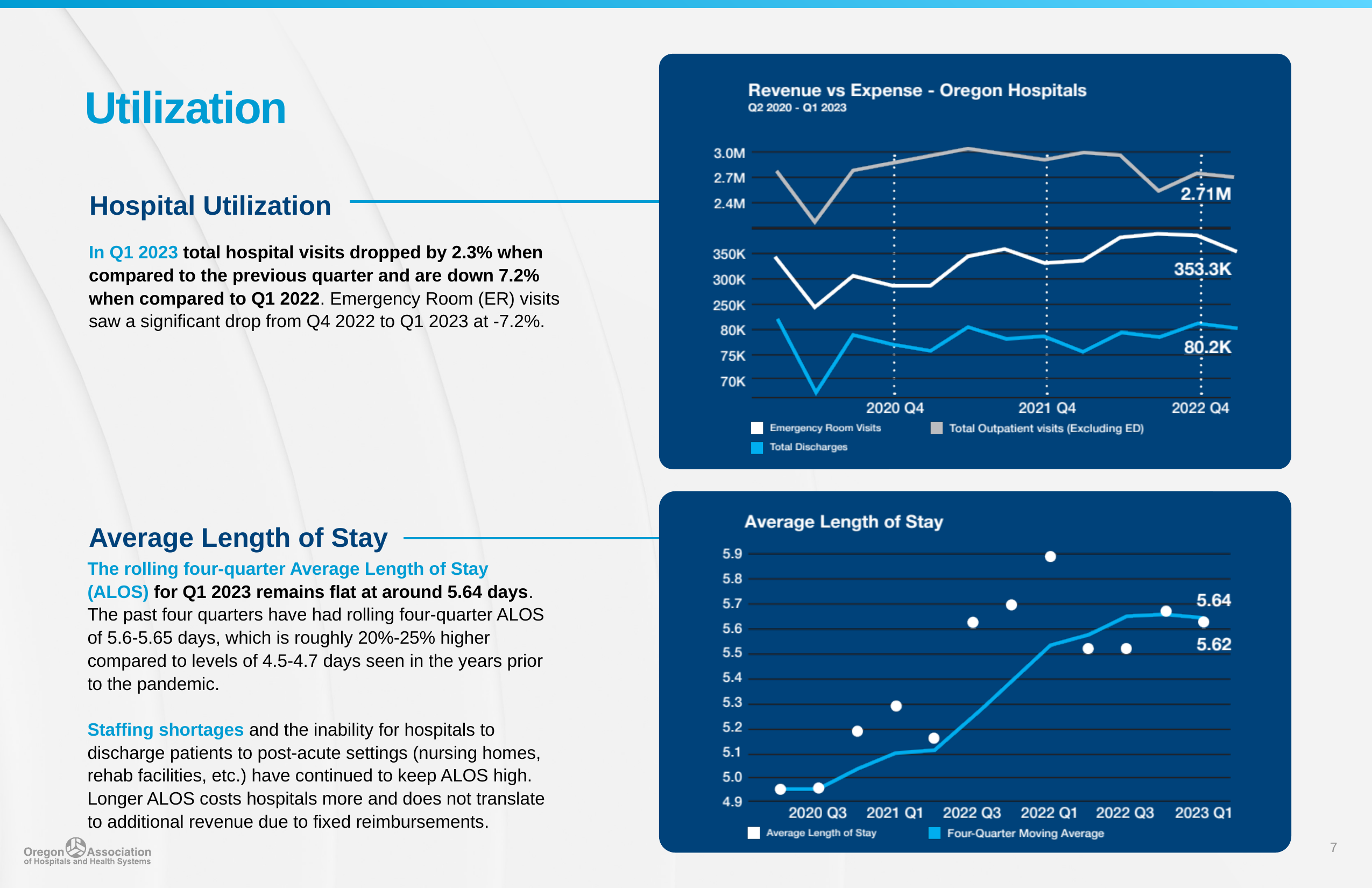
What time period is shown in the subtitle of the 'Revenue vs Expense - Oregon Hospitals' chart? Q2 2020 - Q1 2023 In the 'Average Length of Stay' chart, is the highest Average Length of Stay point greater or less than 5.8? greater How many series does the legend of the 'Revenue vs Expense - Oregon Hospitals' chart list? 3 In the 'Revenue vs Expense - Oregon Hospitals' chart, is the lowest point of the Total Discharges line greater or less than 70K? less In the 'Revenue vs Expense - Oregon Hospitals' chart, what value is labeled at the end of the Total Discharges line? 80.2K In the 'Average Length of Stay' chart, does the Four-Quarter Moving Average line generally rise or fall from left to right? Rise What type of chart is the 'Revenue vs Expense - Oregon Hospitals' chart? Line chart In the 'Revenue vs Expense - Oregon Hospitals' chart, what value is labeled at the end of the Emergency Room Visits line? 353.3K How many Average Length of Stay data points are plotted in the 'Average Length of Stay' chart? 12 How many series does the legend of the 'Average Length of Stay' chart list? 2 In the 'Revenue vs Expense - Oregon Hospitals' chart, what value is labeled at the end of the Total Outpatient visits (Excluding ED) line? 2.71M What type of chart is the 'Average Length of Stay' chart? Line chart